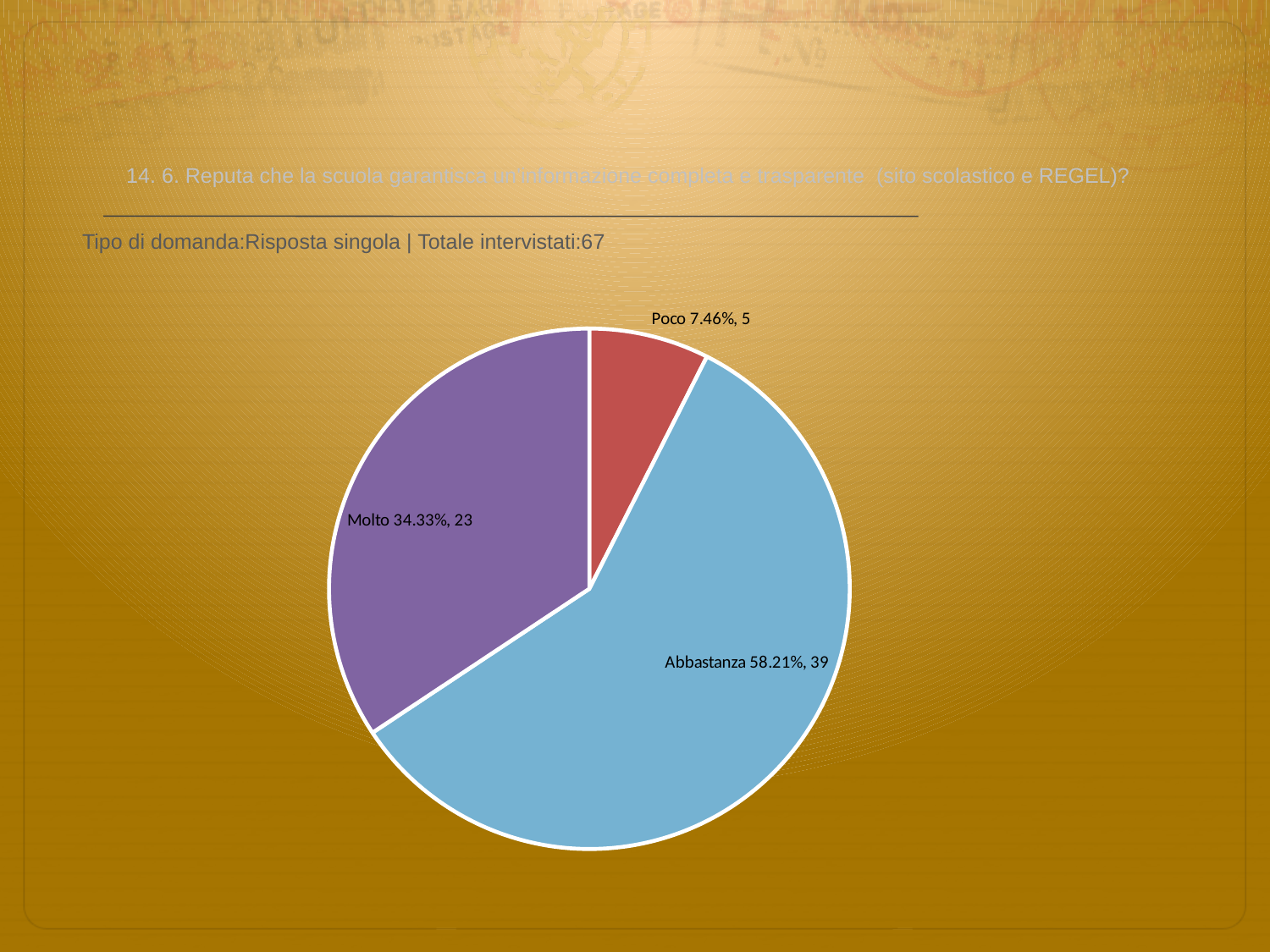
What is the count for the Poco slice? 5 What colour is the Abbastanza slice? light blue What percentage is shown for the Molto slice? 34.33% How many slices does the pie chart have? 3 Which category has the smallest slice? Poco What is the total number of respondents across all slices? 67 What share of the pie does the Poco slice represent? 7.46% Which category has the largest slice? Abbastanza What is the count for the Abbastanza slice? 39 What is the difference in count between Abbastanza and Molto? 16 Which is larger, the Molto slice or the Poco slice? Molto What kind of chart is shown on the slide? pie chart